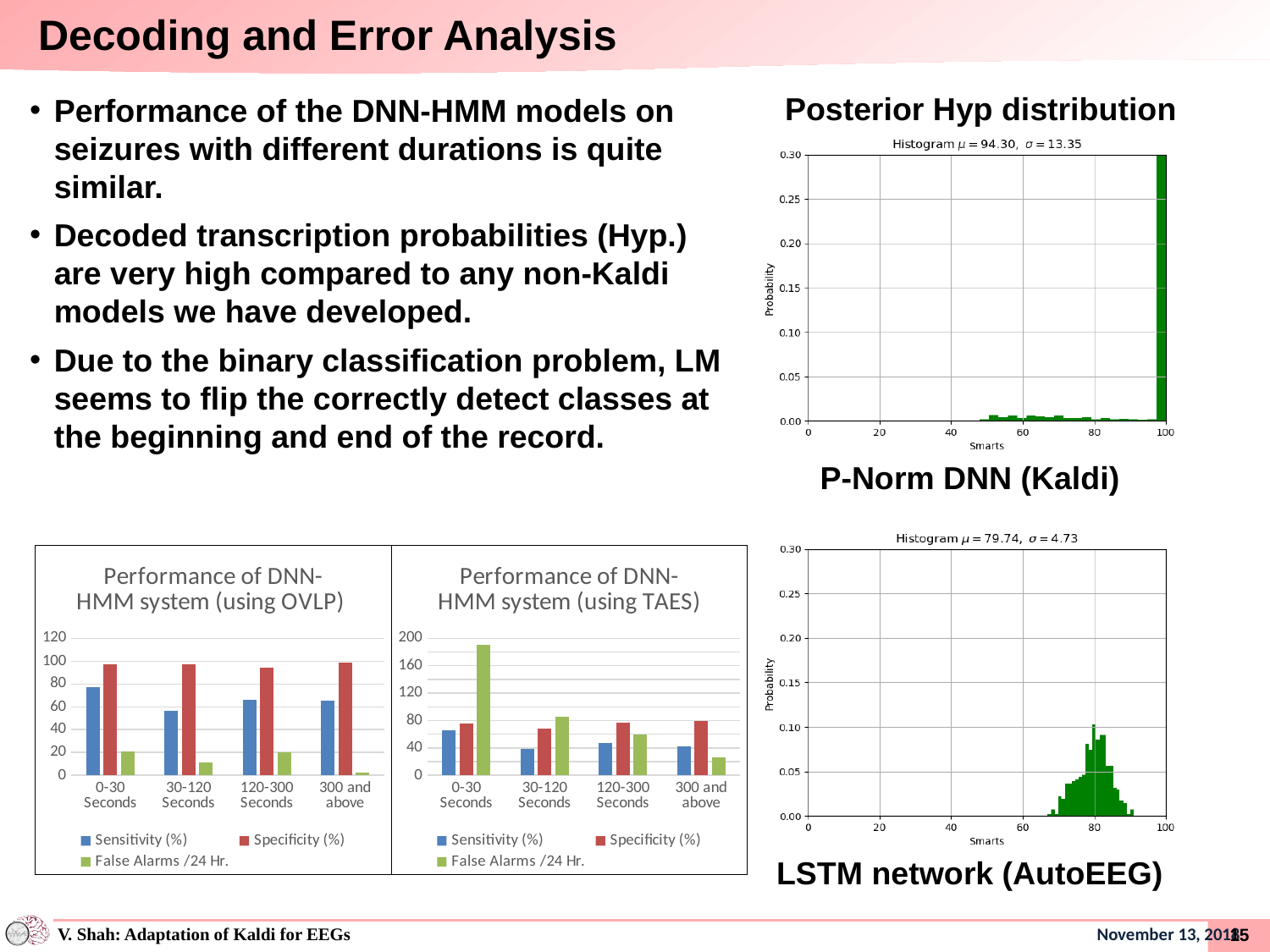
In the LSTM network (AutoEEG) histogram at the bottom right, what standard deviation (σ) is printed in the chart title? 4.73 In the 'Performance of DNN-HMM system (using TAES)' chart, which is larger for 0-30 Seconds: Sensitivity (%) or False Alarms /24 Hr.? False Alarms /24 Hr. In the 'Performance of DNN-HMM system (using OVLP)' chart, is the False Alarms /24 Hr. value for 300 and above greater or less than 20? less In the P-Norm DNN (Kaldi) histogram at the top right, what mean (μ) is printed in the chart title? 94.30 In the 'Performance of DNN-HMM system (using OVLP)' chart, how many series does the legend list? 3 In the 'Performance of DNN-HMM system (using TAES)' chart, is the False Alarms /24 Hr. value for 0-30 Seconds greater or less than 160? greater In the 'Performance of DNN-HMM system (using OVLP)' chart, what kind of chart is shown? bar chart In the 'Performance of DNN-HMM system (using TAES)' chart, how many duration categories are shown on the x axis? 4 In the 'Performance of DNN-HMM system (using OVLP)' chart, is the Sensitivity (%) value for 0-30 Seconds greater or less than 60? greater In the 'Performance of DNN-HMM system (using TAES)' chart, which duration category has the highest False Alarms /24 Hr.? 0-30 Seconds In the 'Performance of DNN-HMM system (using OVLP)' chart, which duration category has the lowest Sensitivity (%)? 30-120 Seconds